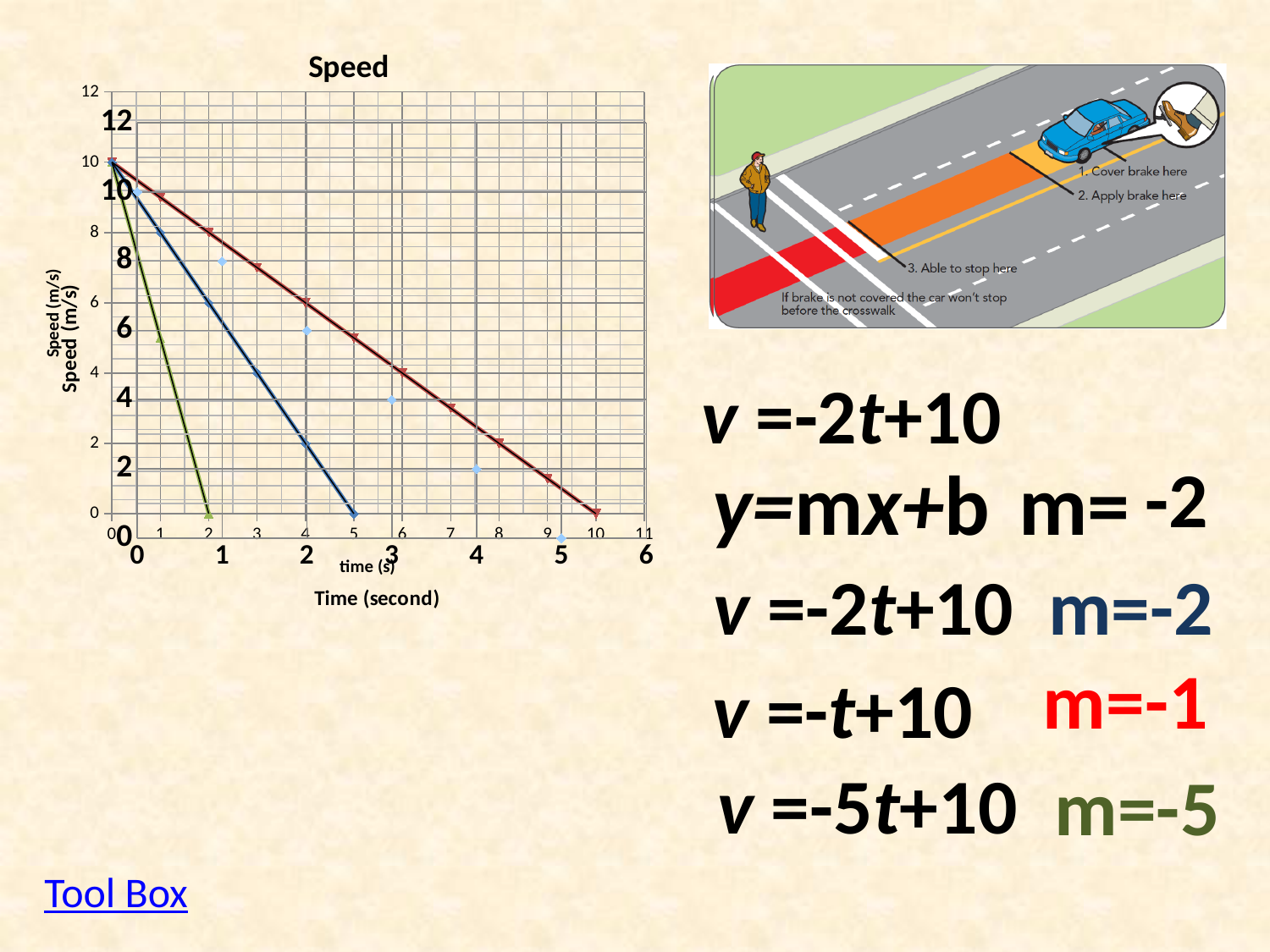
What kind of chart is shown on the slide? line chart What speed value do all the lines start at when time is 0? 10 Which line reaches a speed of 0 first, the green, blue or red line? green line At what time does the red line reach a speed of 0? 10 At time 4, which line shows the higher speed, the red line or the blue line? red line At what time does the green line reach a speed of 0? 2 What is the title of the chart? Speed Is the speed on the red line at time 2 greater or less than 6? greater What is the speed on the red line at time 4? 6 What is the label on the vertical axis of the chart? Speed (m/s) Do the speed values rise or fall as time increases along the x axis? fall At what time does the blue line reach a speed of 0? 5